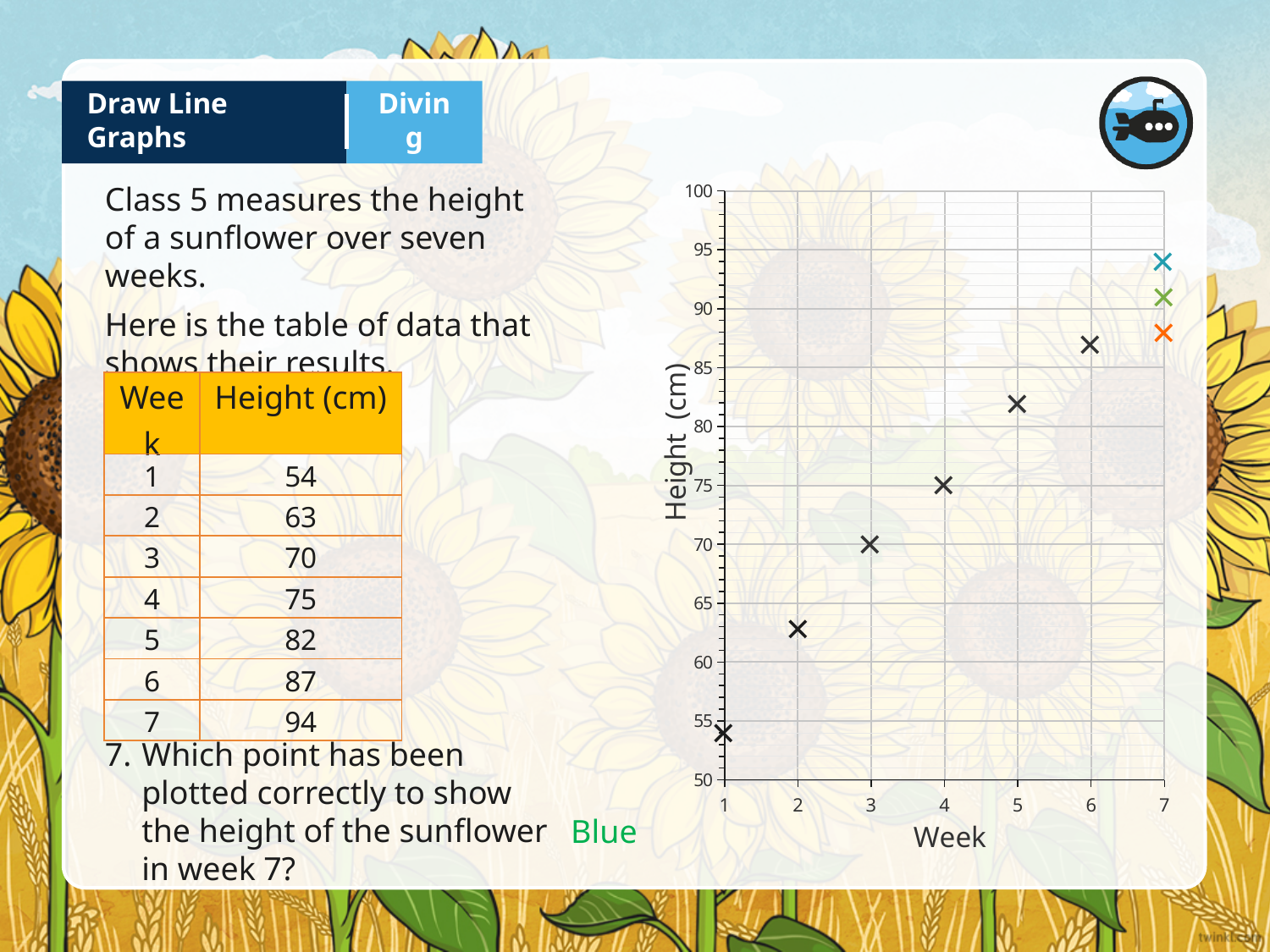
Do the plotted heights rise or fall as the weeks go on? Rise Which week has the larger plotted height, week 3 or week 5? Week 5 What is the label on the y axis of the graph? Height (cm) In which week is the lowest height plotted? Week 1 What is the difference between the plotted heights for week 4 and week 3? 5 What is the plotted height of the sunflower in week 3? 70 What is the plotted height of the sunflower in week 4? 75 How many weeks are shown on the x axis of the graph? 7 Which coloured point is plotted correctly for the height in week 7? Blue In which week is the highest height plotted? Week 7 Is the plotted height for week 2 greater or less than 65? less Is the plotted height for week 5 greater or less than 80? greater